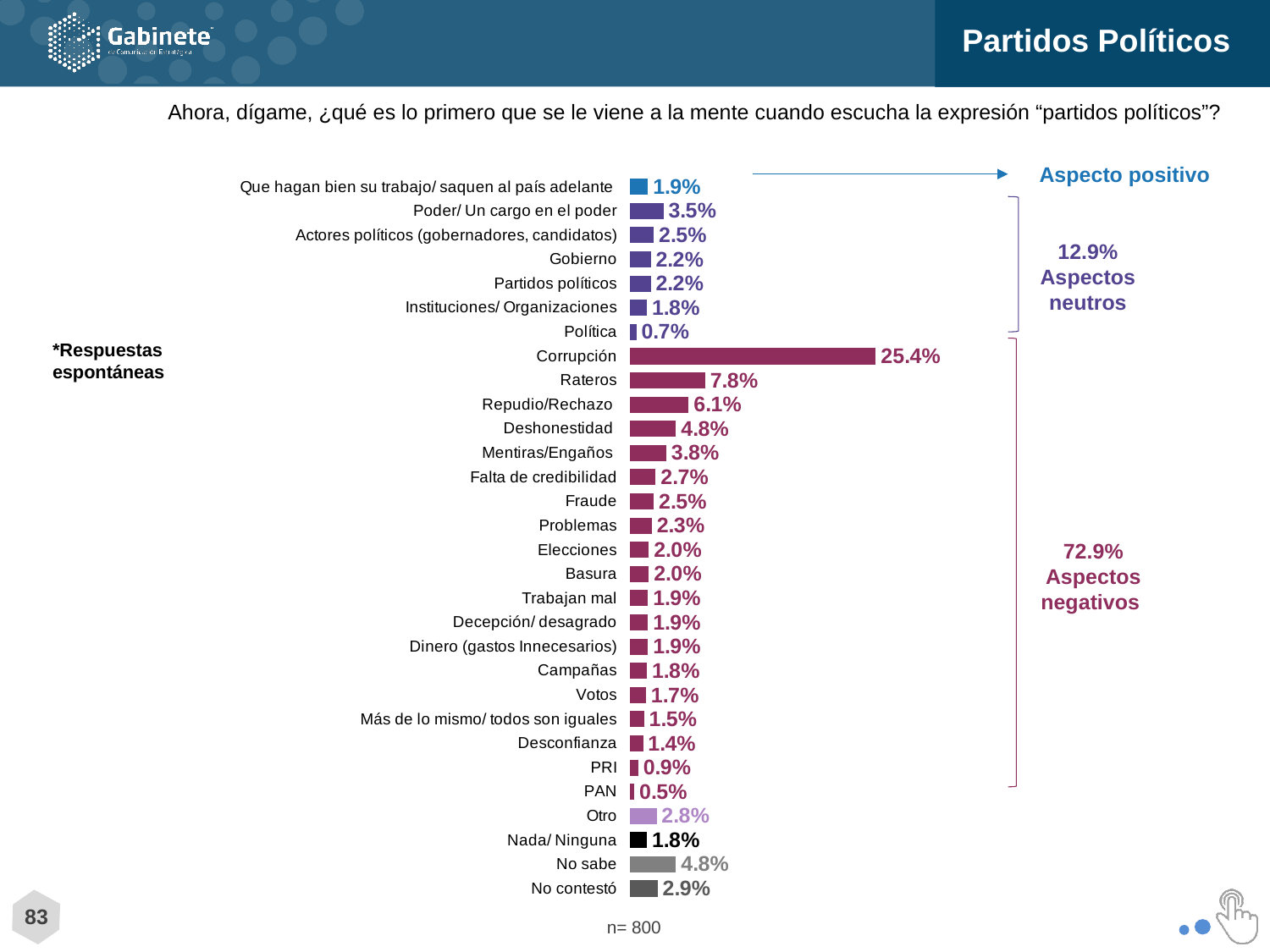
Which is larger, the value for Repudio/Rechazo or the value for Deshonestidad? Repudio/Rechazo What kind of chart is shown on the slide? Bar chart What is the value for No sabe? 4.8% Which category has the highest value? Corrupción Which category has the lowest value? PAN What percentage is given for Aspectos negativos? 72.9% What is the difference between the values for Corrupción and Rateros? 17.6% How many categories are shown in the chart? 30 What is the sample size (n) shown on the slide? n= 800 What is the value for Corrupción? 25.4% What is the value for Poder/ Un cargo en el poder? 3.5% What is the value for Rateros? 7.8%